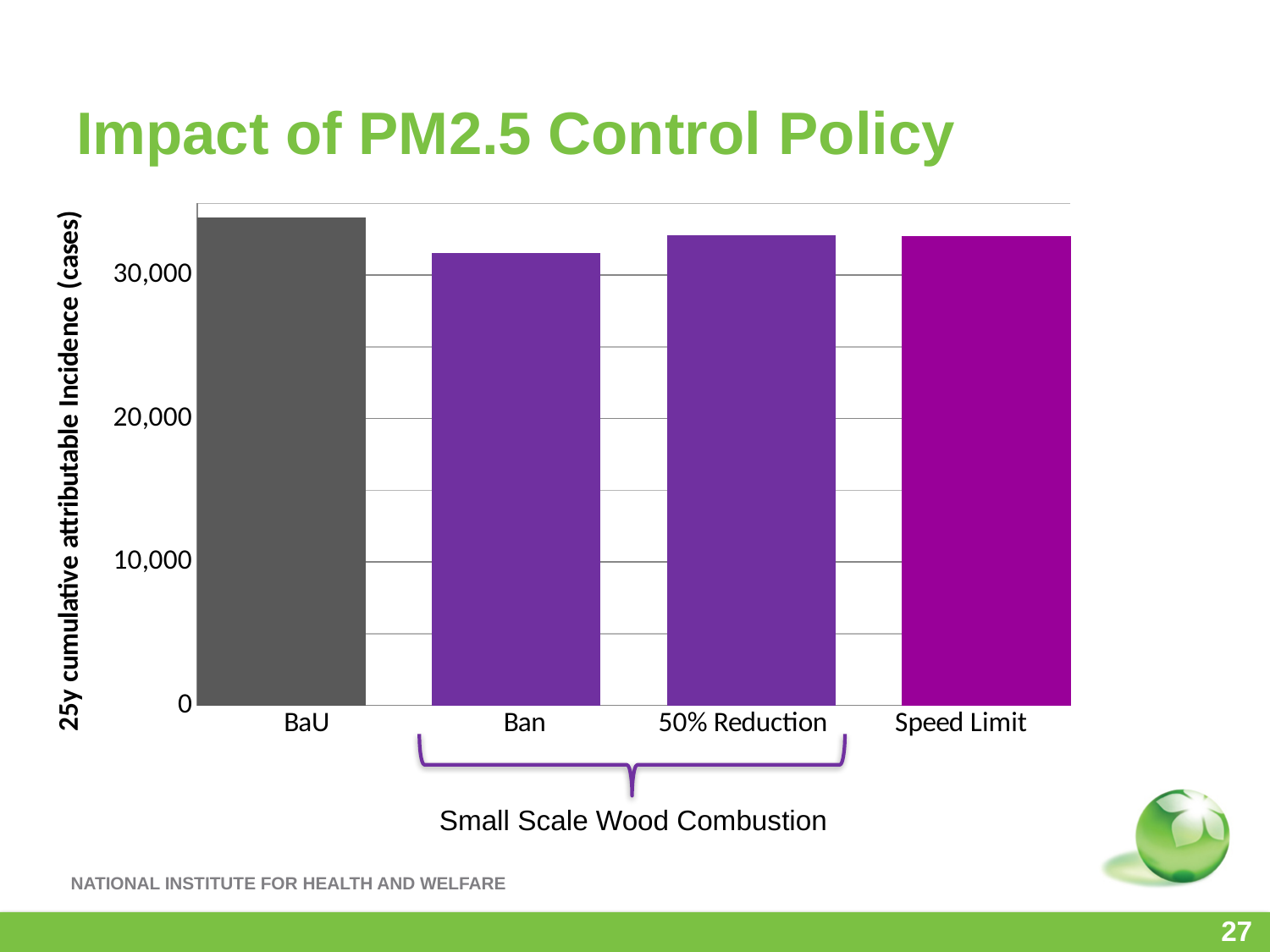
Which is larger, the value for BaU or the value for Speed Limit? BaU Is the value for Speed Limit greater or less than 20,000? greater Which is larger, the value for Ban or the value for 50% Reduction? 50% Reduction Which category has the highest 25y cumulative attributable incidence? BaU Which is larger, the value for BaU or the value for Ban? BaU Which two categories are grouped under the label "Small Scale Wood Combustion"? Ban and 50% Reduction What is the title of the slide containing the chart? Impact of PM2.5 Control Policy Which category has the lowest 25y cumulative attributable incidence? Ban What kind of chart is shown on the slide? bar chart How many categories are shown on the x axis of the chart? 4 Is the value for Ban greater or less than 30,000? greater Is the value for BaU greater or less than 30,000? greater